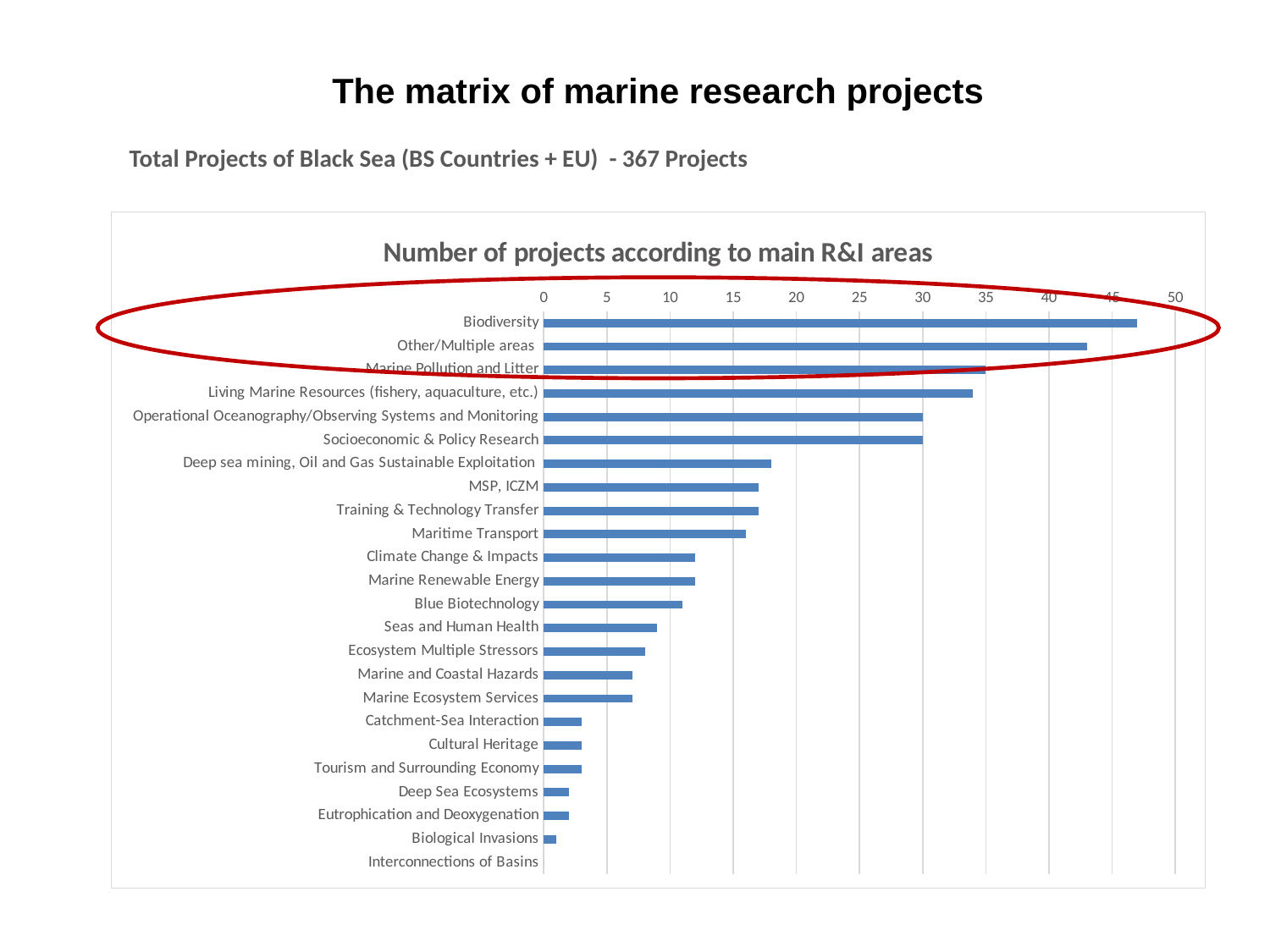
Which R&I area has the lowest number of projects? Interconnections of Basins What is the title of the chart? Number of projects according to main R&I areas Is the value for Biodiversity greater or less than 45? greater Is the value for Climate Change & Impacts greater or less than 15? less How many R&I areas are listed on the chart? 24 Is the value for Other/Multiple areas greater or less than 40? greater Which has more projects, Living Marine Resources (fishery, aquaculture, etc.) or Maritime Transport? Living Marine Resources (fishery, aquaculture, etc.) Which R&I area has the highest number of projects? Biodiversity What kind of chart is shown on the slide? bar chart Which has more projects, Biodiversity or Other/Multiple areas? Biodiversity